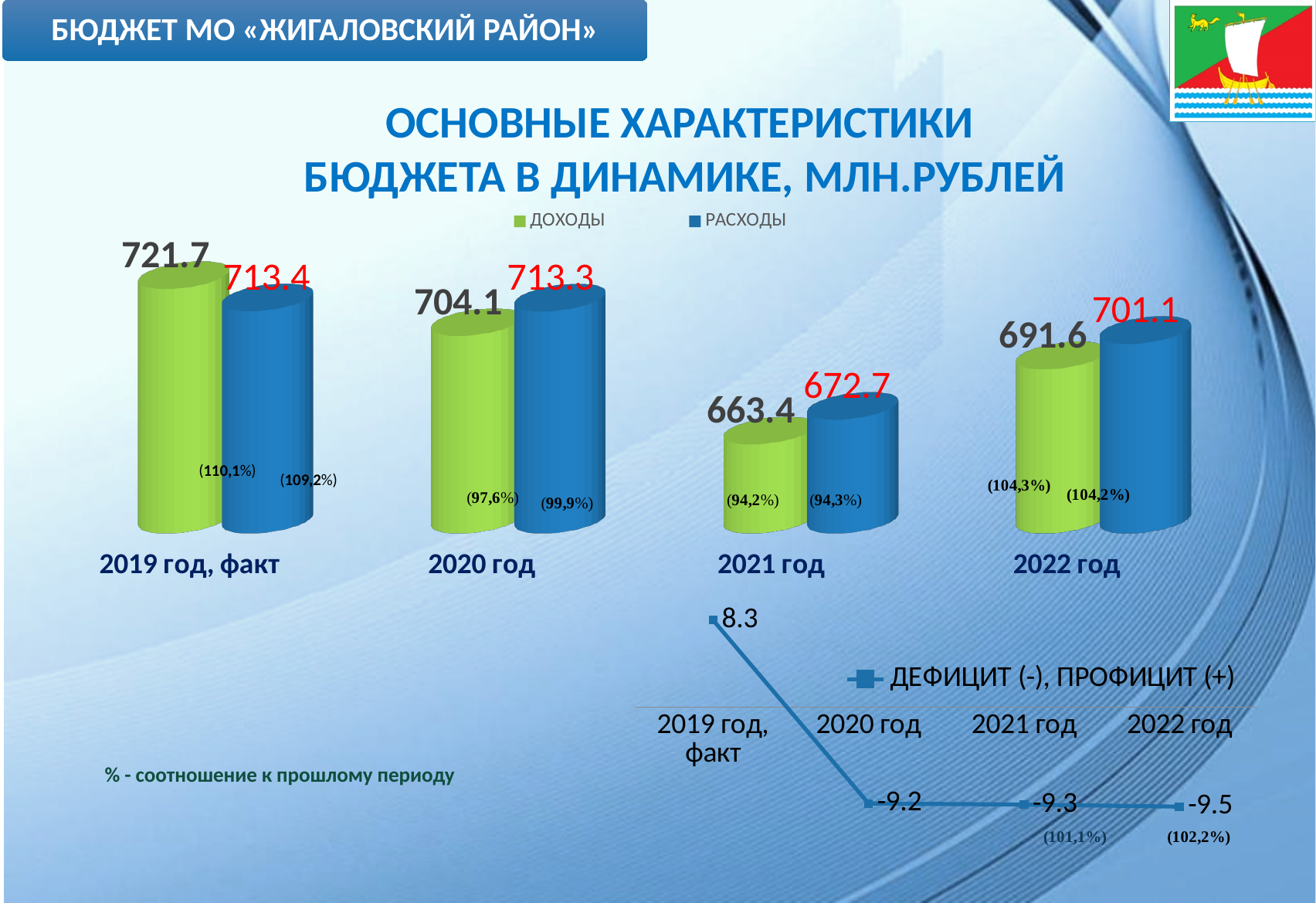
In the line chart ДЕФИЦИТ (-), ПРОФИЦИТ (+), what is the value for 2022 год? -9.5 In the bar chart, what is the value of РАСХОДЫ for 2022 год? 701.1 In the bar chart, which is larger for 2019 год, факт: ДОХОДЫ or РАСХОДЫ? ДОХОДЫ In the bar chart, which year has the highest РАСХОДЫ value? 2019 год, факт In the bar chart, which year has the lowest ДОХОДЫ value? 2021 год In the bar chart, what is the value of ДОХОДЫ for 2019 год, факт? 721.7 In the bar chart, what is the value of РАСХОДЫ for 2021 год? 672.7 In the line chart ДЕФИЦИТ (-), ПРОФИЦИТ (+), what is the value for 2019 год, факт? 8.3 In the bar chart, what is the difference between РАСХОДЫ and ДОХОДЫ for 2020 год? 9.2 How many series does the legend of the bar chart list? 2 What type of chart is the lower chart titled ДЕФИЦИТ (-), ПРОФИЦИТ (+)? line chart How many year categories are shown in the bar chart? 4